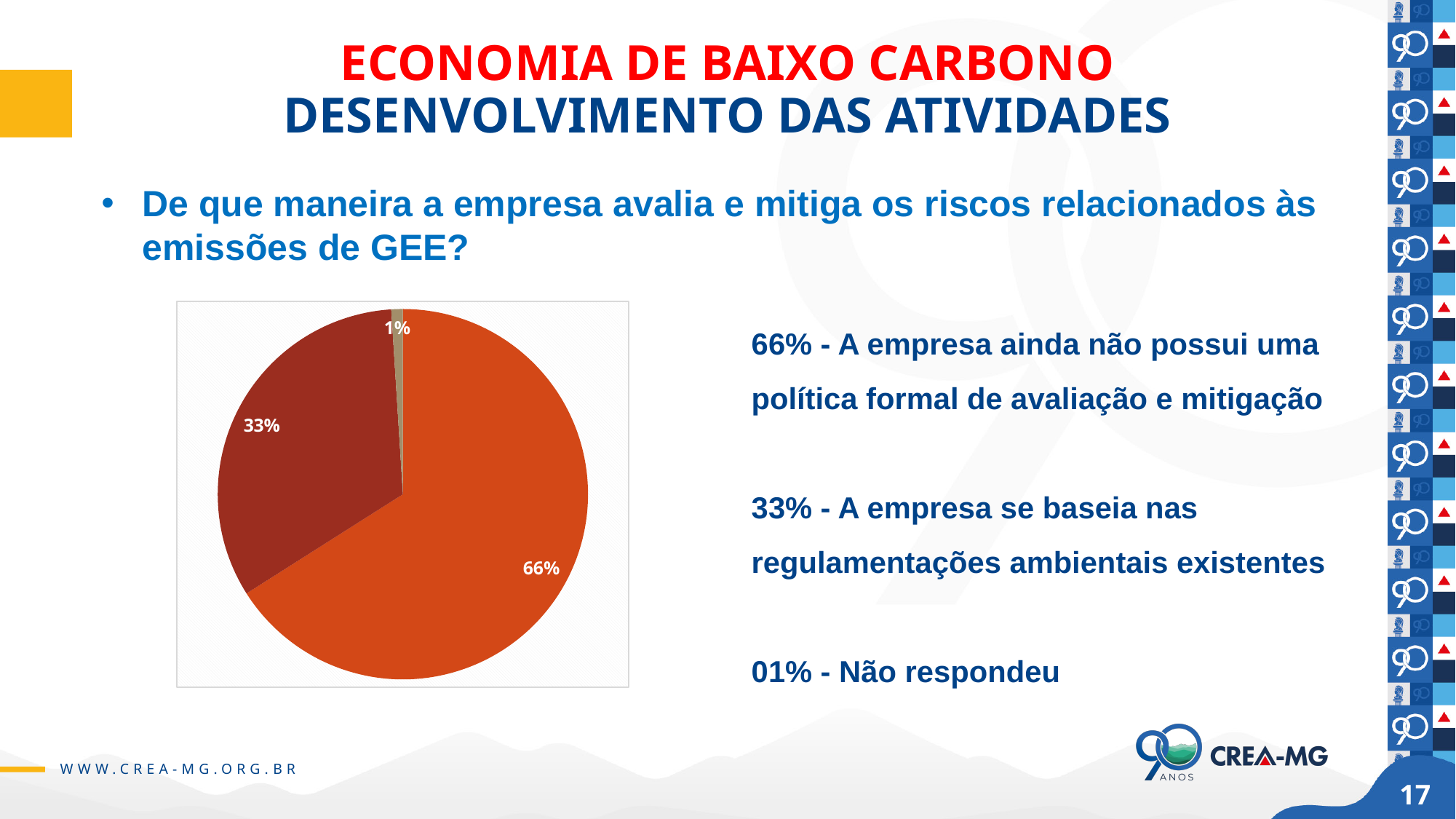
What share of the pie corresponds to 'A empresa se baseia nas regulamentações ambientais existentes'? 33% What percentage of respondents did not answer ('Não respondeu')? 01% What is the total of the three percentages shown on the pie chart? 100% What percentage is shown for the smallest slice of the pie chart? 1% Which response option accounts for the largest share of the pie? A empresa ainda não possui uma política formal de avaliação e mitigação Which is larger: the slice for companies without a formal policy or the slice for companies relying on existing environmental regulations? companies without a formal policy (66%) What percentage is shown for the largest slice of the pie chart? 66% What colour is the largest slice of the pie chart? orange-red What share of the pie corresponds to 'A empresa ainda não possui uma política formal de avaliação e mitigação'? 66% What is the difference in percentage points between the 66% slice and the 33% slice? 33 What kind of chart is shown on the slide? pie chart How many slices does the pie chart have? 3